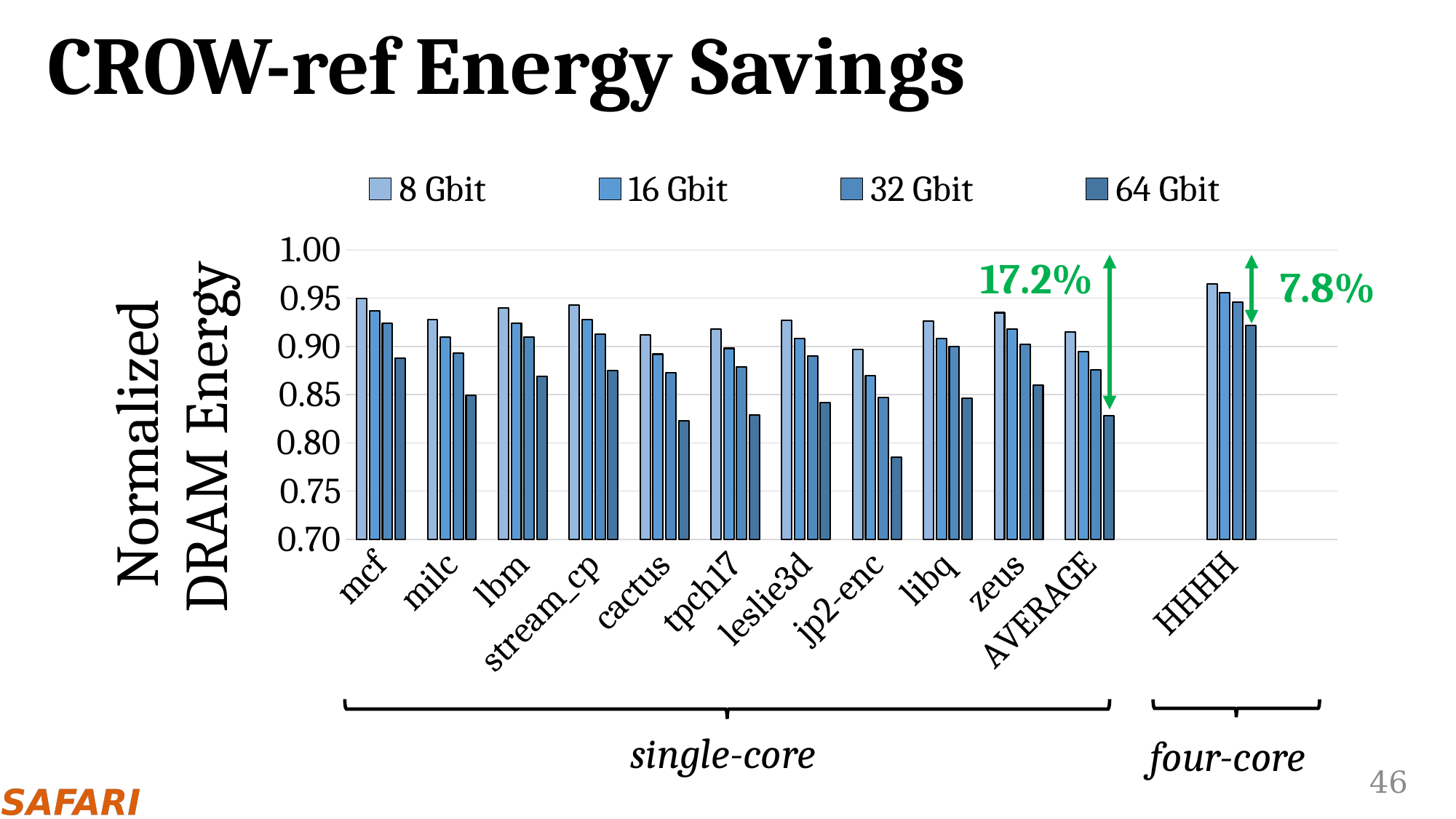
How many workload categories are shown along the x axis? 12 Is the 64 Gbit value for jp2-enc greater or less than 0.80? less What kind of chart is shown on the slide? bar chart Is the 64 Gbit value for mcf greater or less than 0.90? less Within each workload, do the bars rise or fall as the DRAM capacity increases from 8 Gbit to 64 Gbit? fall What energy saving percentage is annotated for the single-core AVERAGE at 64 Gbit? 17.2% Is the 64 Gbit value for cactus greater or less than 0.85? less How many series does the legend list? 4 Which workload has the highest 8 Gbit normalized DRAM energy? HHHH Which workload has the lowest 64 Gbit normalized DRAM energy? jp2-enc Which is larger, the 64 Gbit value for libq or the 64 Gbit value for jp2-enc? libq